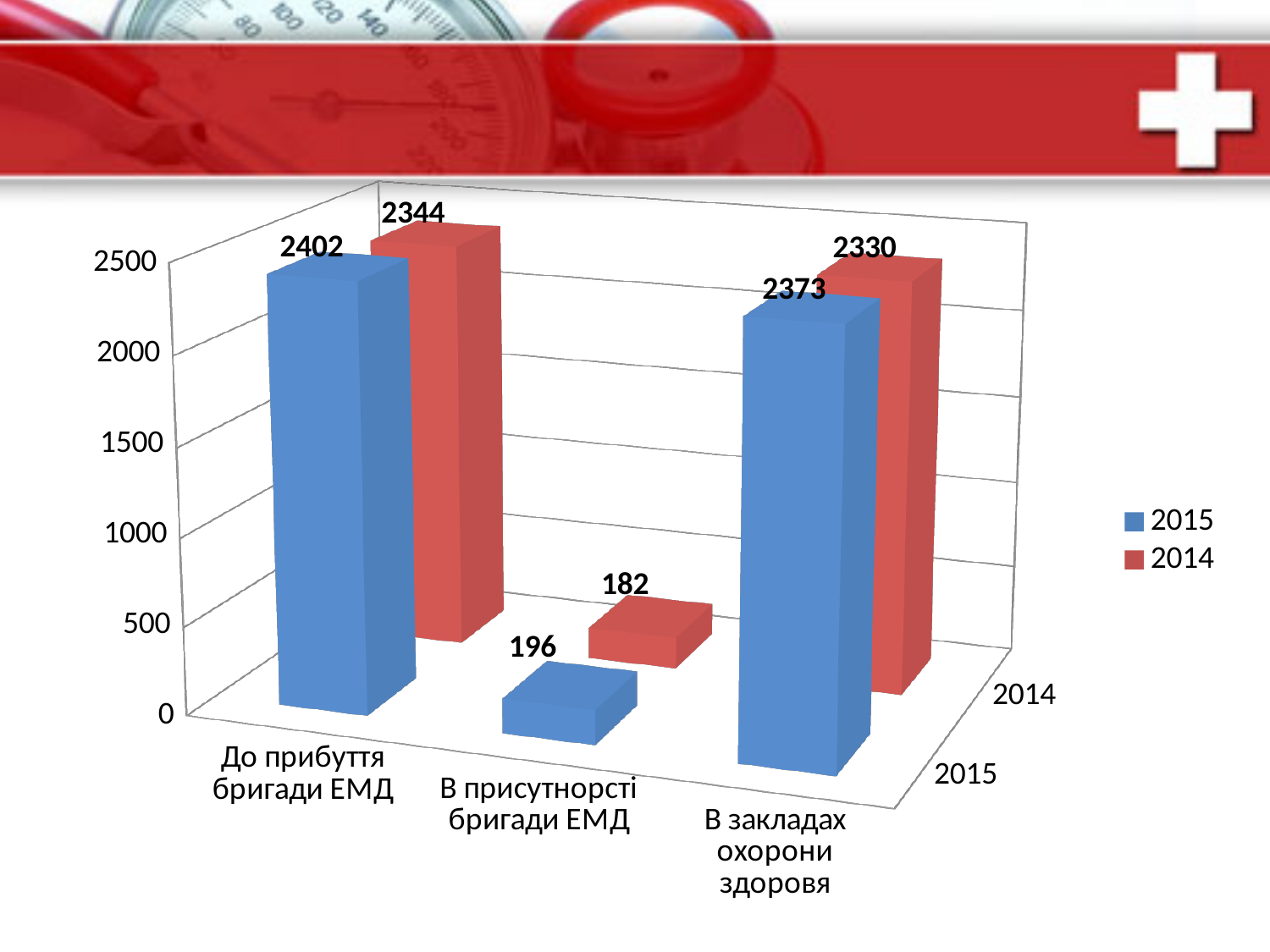
What is the value for 2015 in the category "В присутнорсті бригади ЕМД"? 196 What is the value for 2014 in the category "В присутнорсті бригади ЕМД"? 182 What is the value for 2014 in the category "В закладах охорони здоровя"? 2330 What is the difference between the 2015 and 2014 values in the category "В закладах охорони здоровя"? 43 What kind of chart is shown on the slide? Bar chart How many categories are shown on the x axis of the chart? 3 Which category has the highest value for the 2014 series? До прибуття бригади ЕМД How many series does the chart legend list? 2 In the category "В присутнорсті бригади ЕМД", which series has the larger value, 2015 or 2014? 2015 Which category has the lowest value for the 2015 series? В присутнорсті бригади ЕМД What is the value for 2015 in the category "До прибуття бригади ЕМД"? 2402 What is the difference between the 2015 and 2014 values in the category "До прибуття бригади ЕМД"? 58